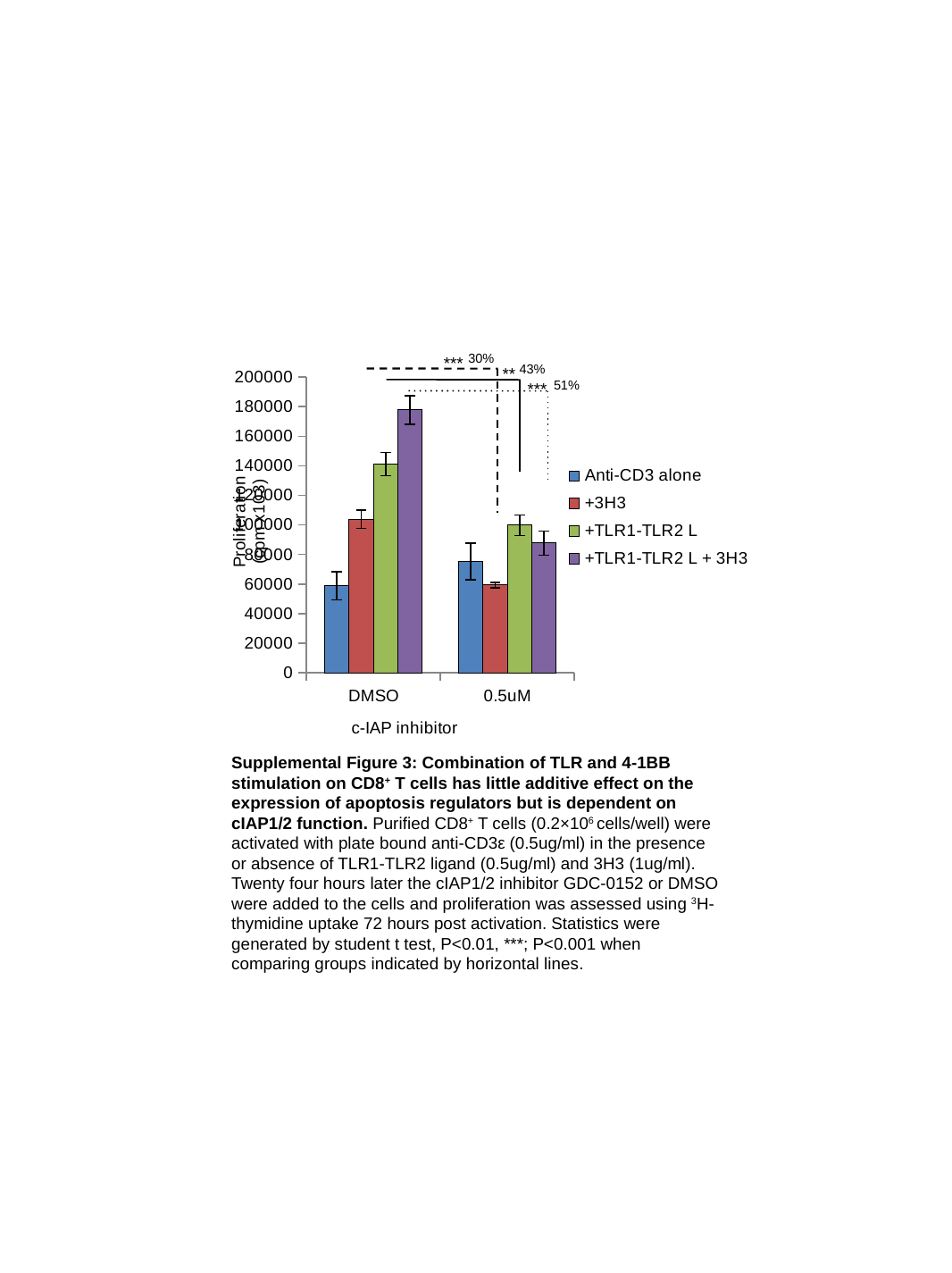
How many categories are shown on the x axis? 2 What kind of chart is shown on the slide? bar chart Which series has the highest value in the 0.5uM group? +TLR1-TLR2 L Which series has the highest value in the DMSO group? +TLR1-TLR2 L + 3H3 Is the value for +TLR1-TLR2 L in the DMSO group greater or less than 120000? greater Which is larger: +TLR1-TLR2 L + 3H3 in the DMSO group or +TLR1-TLR2 L + 3H3 in the 0.5uM group? DMSO Is the value for +TLR1-TLR2 L + 3H3 in the DMSO group greater or less than 160000? greater How many series does the legend list? 4 Which colour represents the +3H3 series in the legend? red Which series has the lowest value in the DMSO group? Anti-CD3 alone Is the value for Anti-CD3 alone in the DMSO group greater or less than 80000? less What is the x-axis title of the chart? c-IAP inhibitor